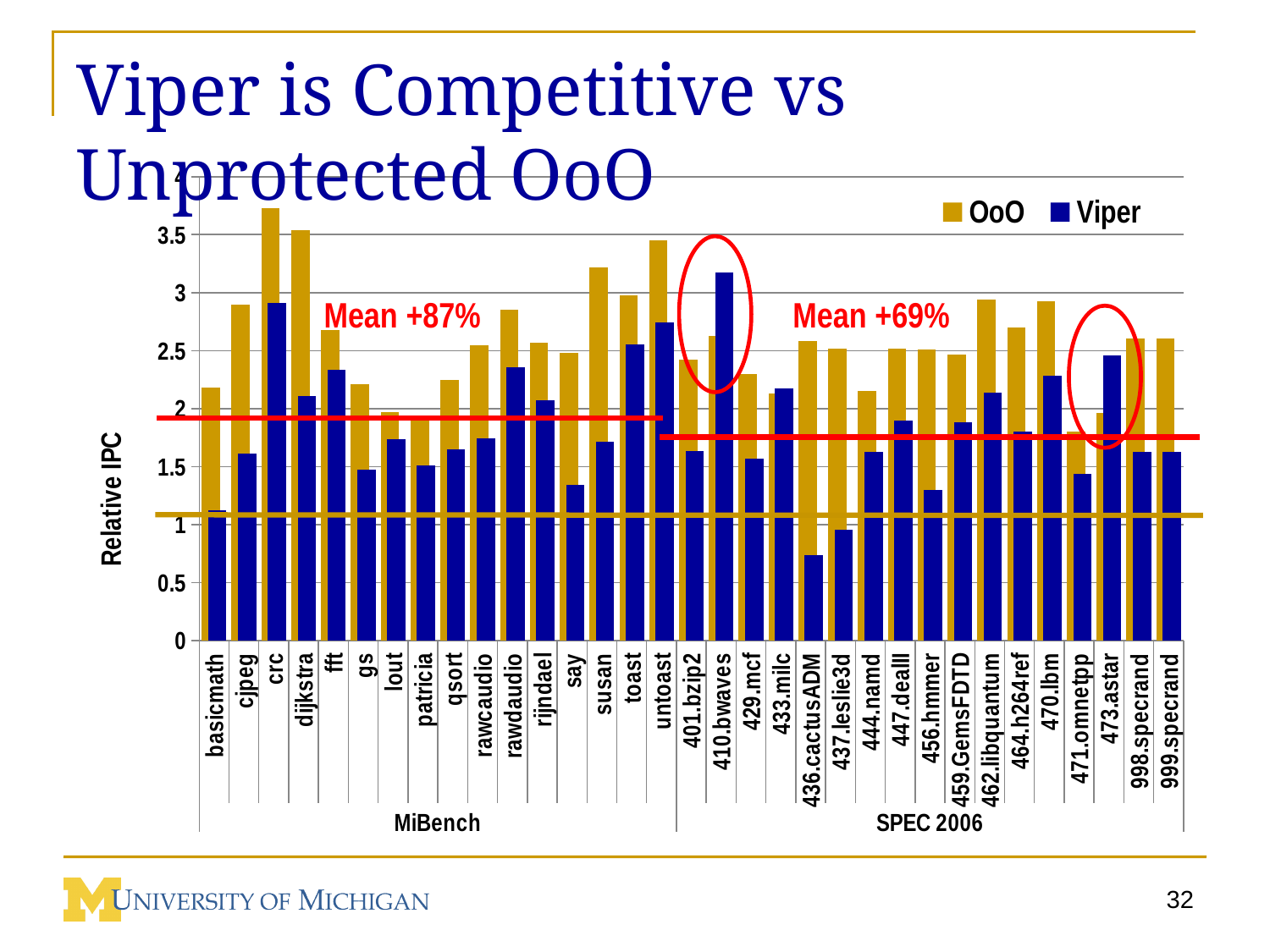
Is the OoO value for crc greater or less than 3.5? greater What kind of chart is shown on the slide? bar chart What is the label on the y axis? Relative IPC What are the two series named in the legend? OoO and Viper For 410.bwaves, which series has the larger value, OoO or Viper? Viper Which benchmark has the highest Viper bar? 410.bwaves How many benchmark categories are shown on the x axis in total? 33 How many benchmarks are in the MiBench group? 16 Which benchmark has the highest OoO bar? crc How many series does the legend list? 2 Is the Viper value for 436.cactusADM greater or less than 1? less Which benchmark has the lowest Viper bar? 436.cactusADM